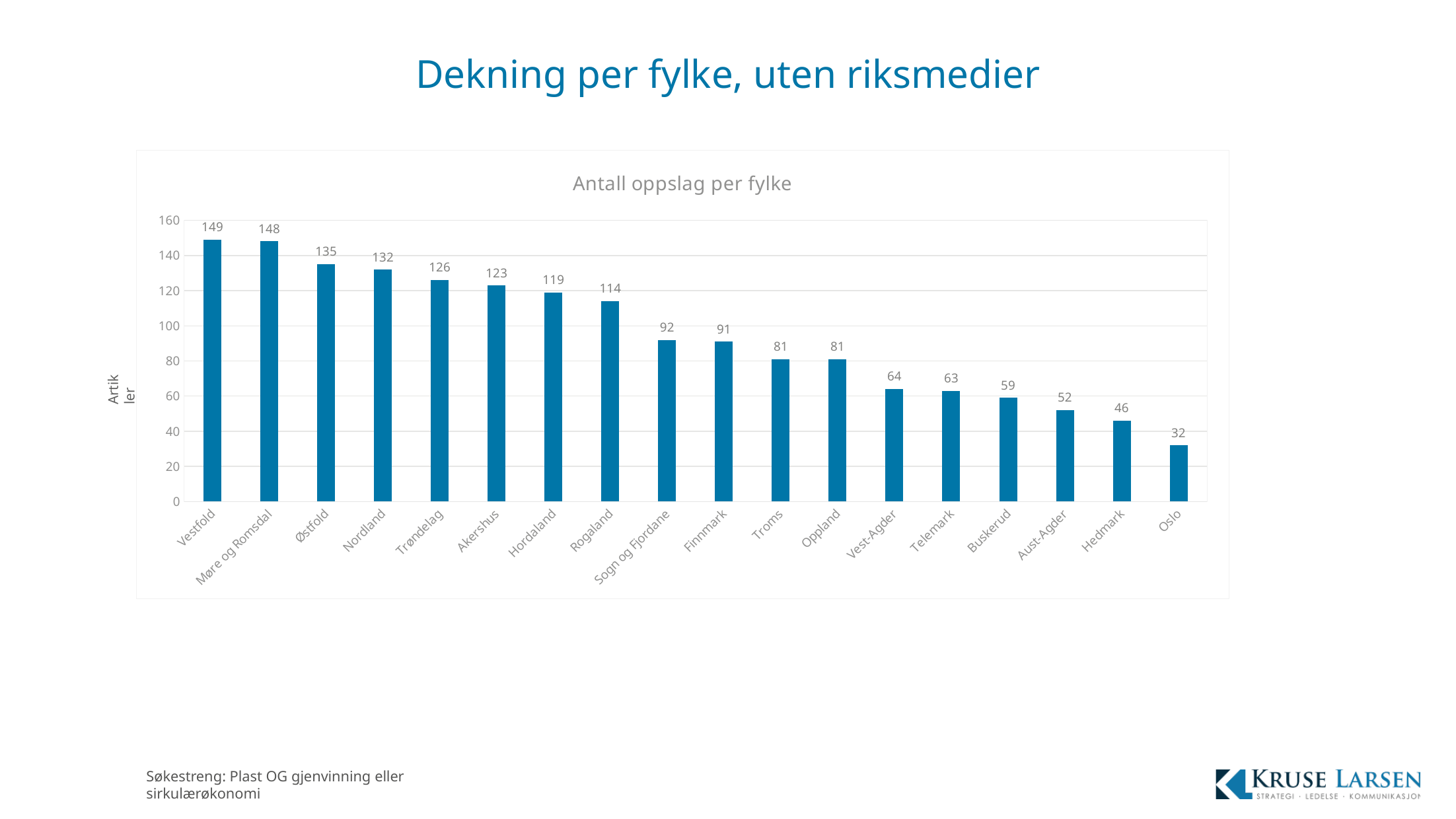
What is the difference between the values for Vestfold and Oslo? 117 What is the value for Sogn og Fjordane? 92 Which county has the lowest number of articles? Oslo What is the value for Vestfold? 149 What is the title of the chart? Antall oppslag per fylke What is the value for Oslo? 32 What is the difference between the values for Østfold and Nordland? 3 Is the value for Rogaland greater or less than 100? greater How many counties are shown in the chart? 18 Which is larger, the value for Hordaland or the value for Finnmark? Hordaland Which county has the highest number of articles? Vestfold What kind of chart is shown on the slide? Bar chart